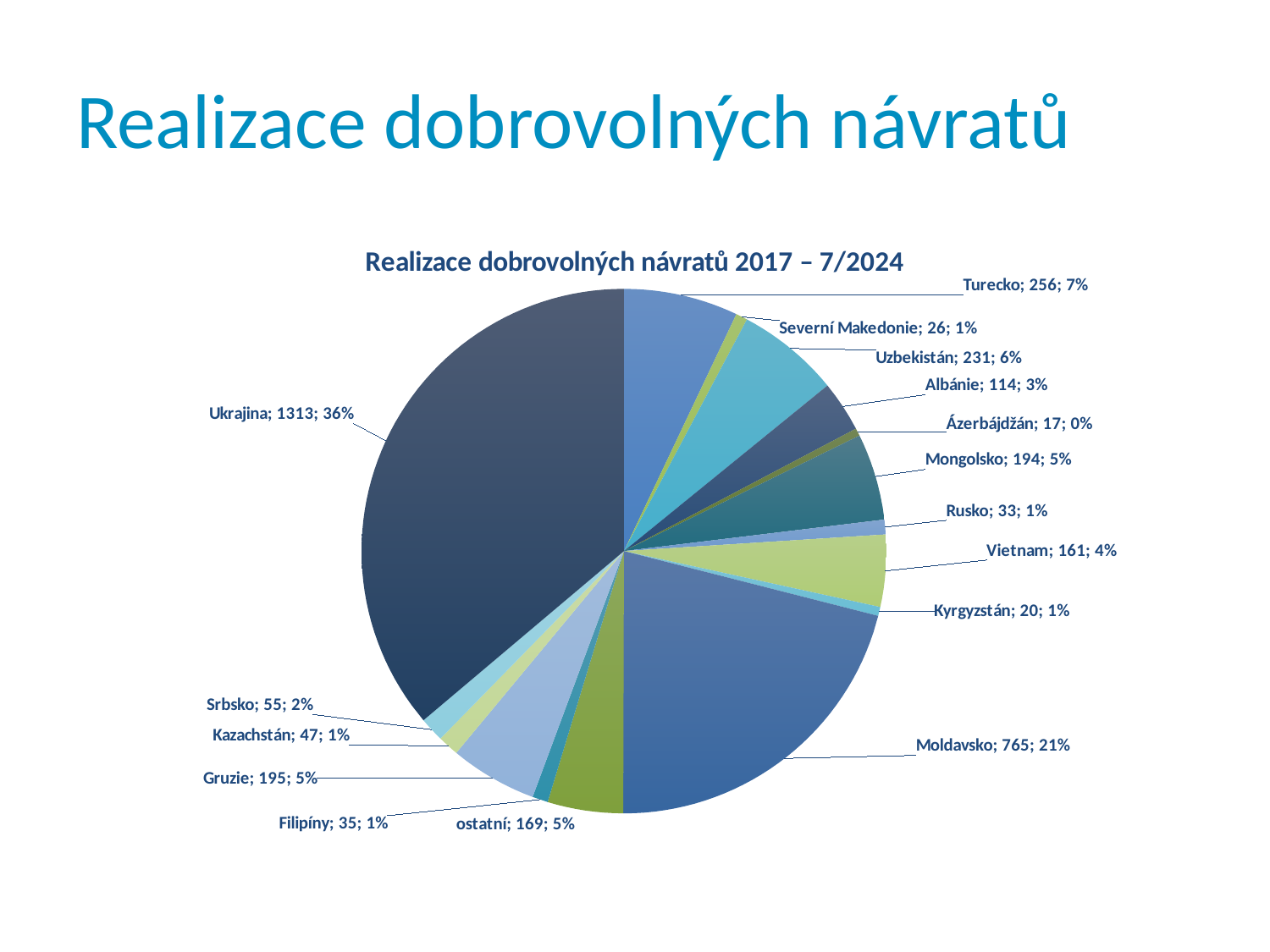
Which category has the smallest slice? Ázerbájdžán What share of the pie does Turecko represent? 7% What is the value for Ukrajina? 1313 How many slices does the pie chart have? 16 What is the difference between the values for Ukrajina and Moldavsko? 548 What is the value for Mongolsko? 194 What is the title of the chart? Realizace dobrovolných návratů 2017 – 7/2024 What share of the pie does Ukrajina represent? 36% What is the value for Moldavsko? 765 What type of chart is shown on the slide? pie chart Which is larger, the value for Uzbekistán or the value for Gruzie? Uzbekistán Which category has the largest slice? Ukrajina